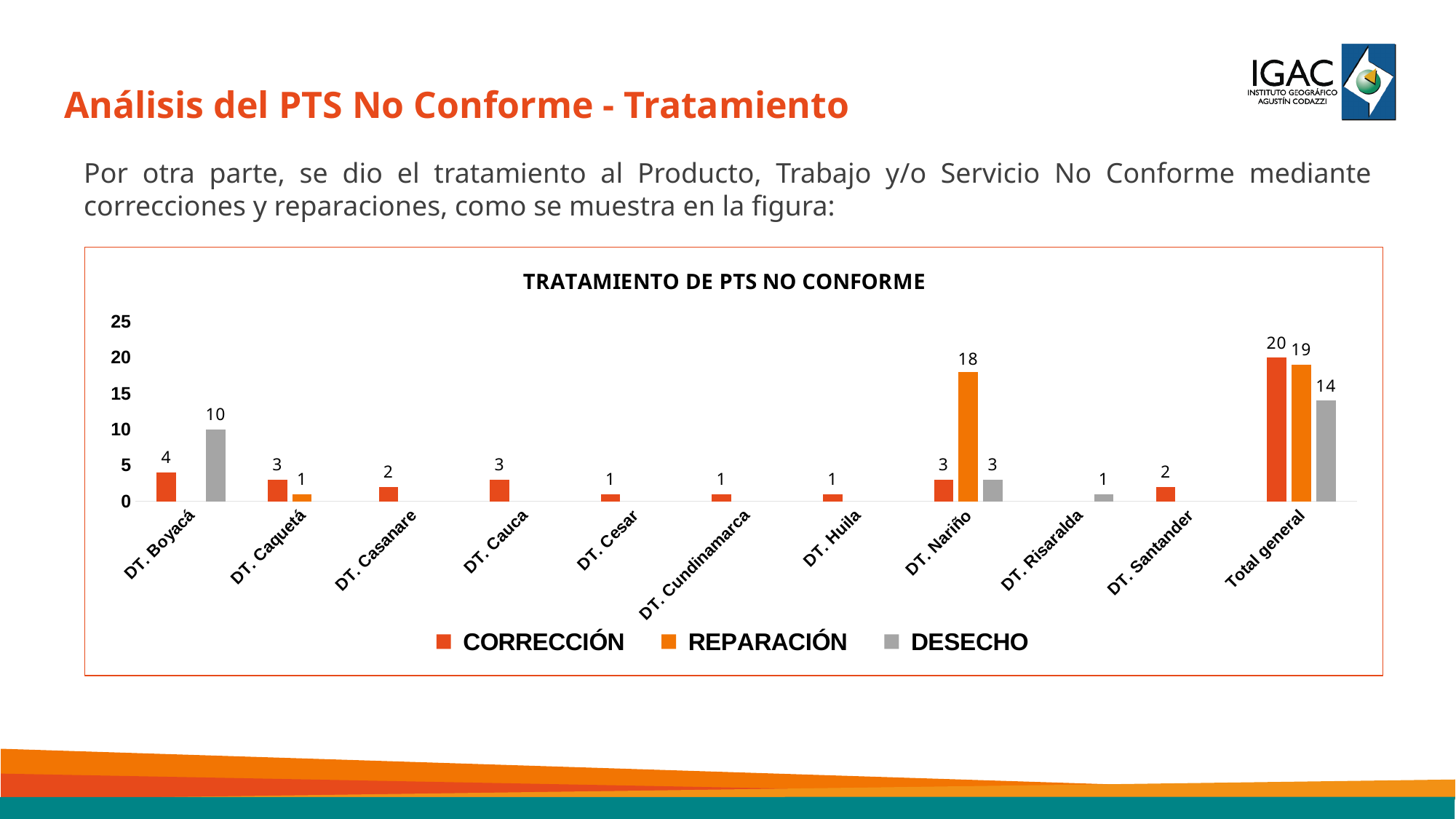
How many series does the legend list? 3 What type of chart is shown? Bar chart What is the DESECHO value for DT. Boyacá? 10 What is the REPARACIÓN value for DT. Nariño? 18 What is the CORRECCIÓN value for DT. Boyacá? 4 How many categories are shown on the x axis? 11 What is the difference between the CORRECCIÓN and REPARACIÓN values for Total general? 1 Which category has the highest REPARACIÓN value? Total general Excluding Total general, which category has the highest DESECHO value? DT. Boyacá Is the REPARACIÓN value for DT. Nariño greater or less than 15? greater Which is larger for DT. Caquetá, CORRECCIÓN or REPARACIÓN? CORRECCIÓN What is the DESECHO value for Total general? 14